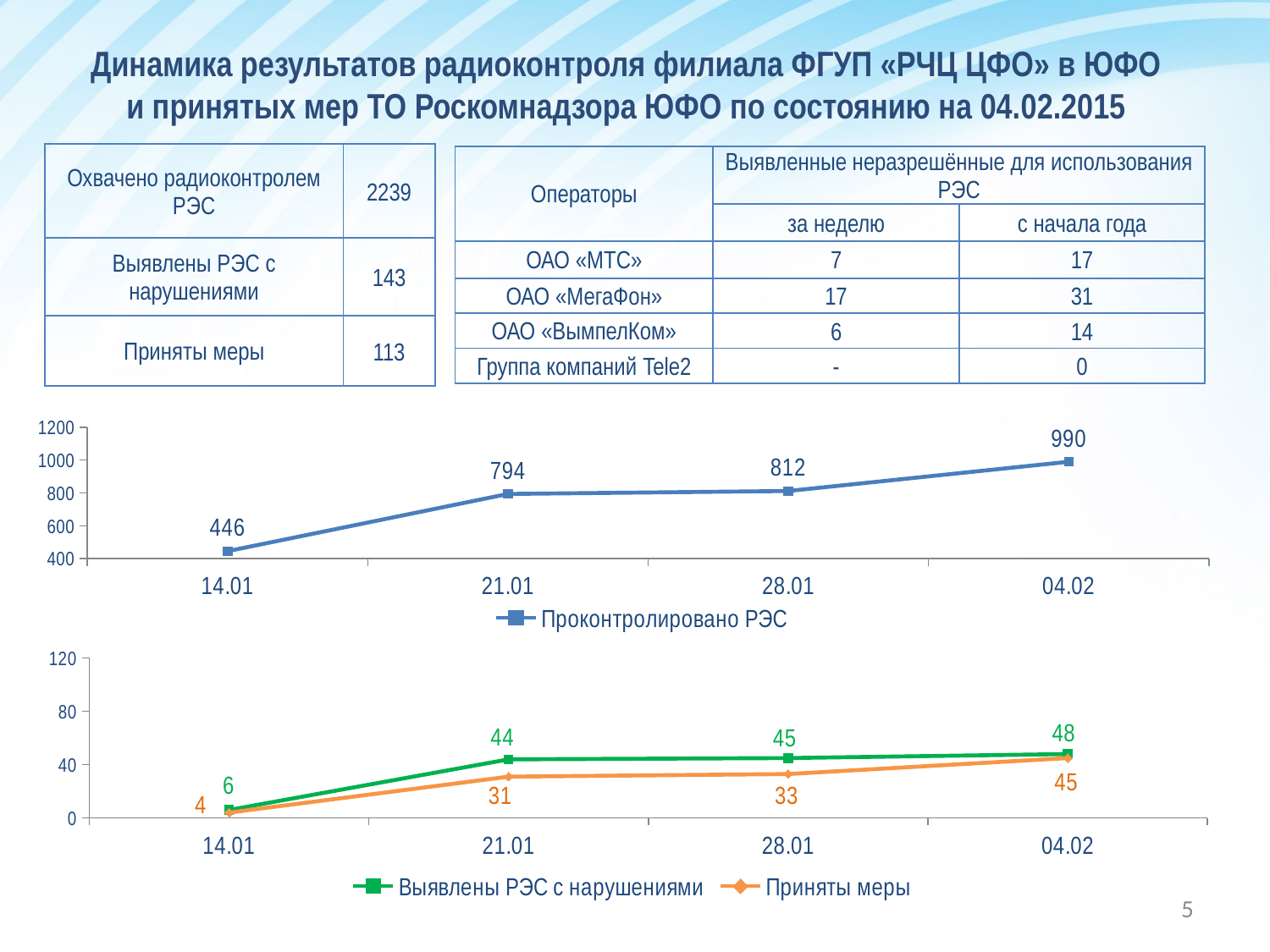
In the upper chart (Проконтролировано РЭС), what is the value for 04.02? 990 In the upper chart (Проконтролировано РЭС), which date has the lowest value? 14.01 In the lower chart, what is the value of Приняты меры for 28.01? 33 In the upper chart (Проконтролировано РЭС), what is the difference between the values for 04.02 and 28.01? 178 In the lower chart, what is the difference between Выявлены РЭС с нарушениями and Приняты меры on 21.01? 13 In the upper chart (Проконтролировано РЭС), do the values rise or fall from 14.01 to 04.02? rise In the upper chart (Проконтролировано РЭС), what is the value for 14.01? 446 In the lower chart, what is the value of Выявлены РЭС с нарушениями for 21.01? 44 In the upper chart (Проконтролировано РЭС), how many data points are plotted? 4 What type of chart is the lower chart? line chart In the lower chart, which date has the highest value for Приняты меры? 04.02 In the lower chart, how many series does the legend list? 2